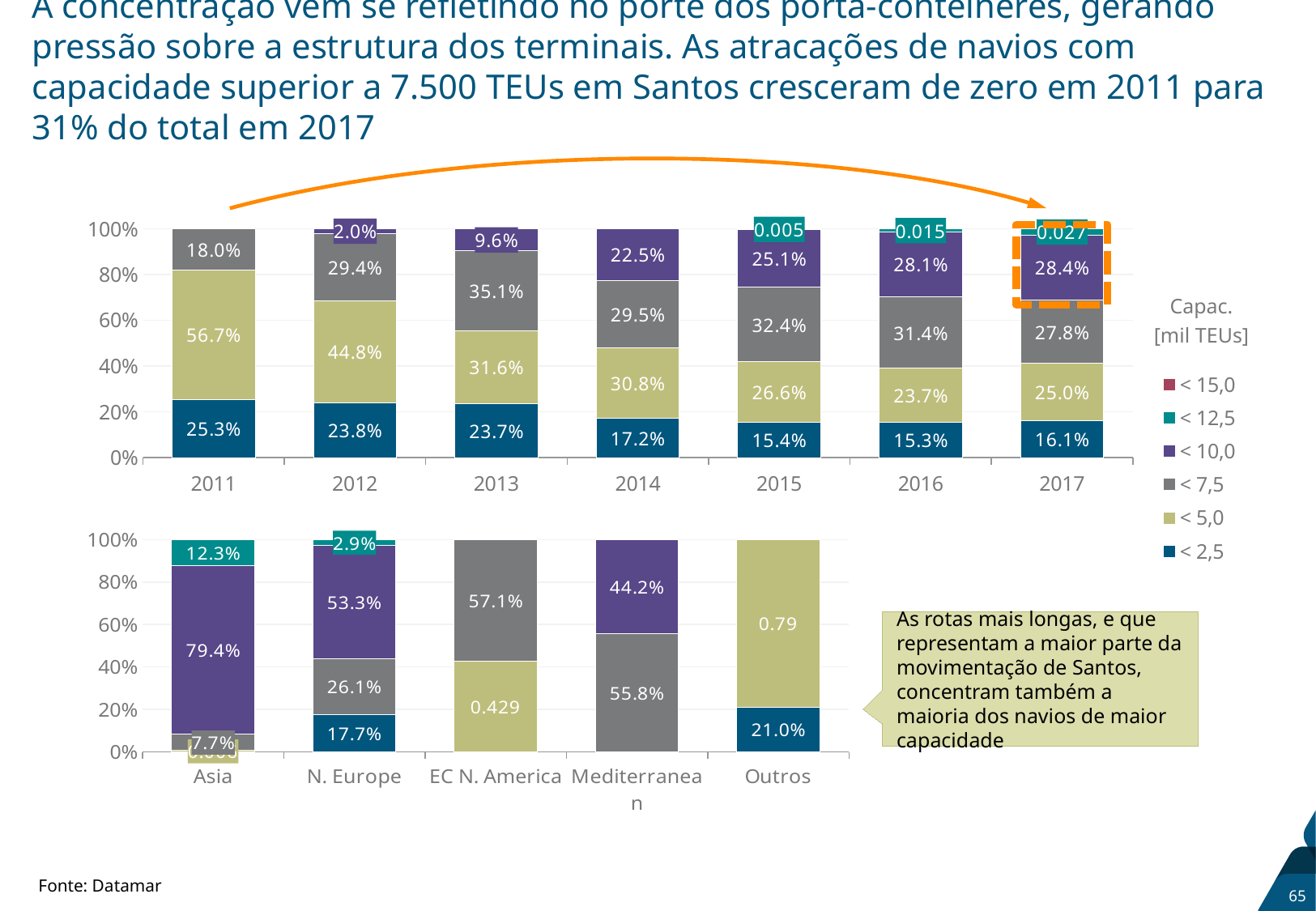
In the top chart, which year has the highest value for the '< 2,5' series? 2011 What kind of chart is the top chart? stacked bar chart In the bottom chart, for Mediterranean, which is larger: the '< 7,5' series or the '< 10,0' series? < 7,5 How many years are shown on the x axis of the top chart? 7 In the bottom chart, what is the value of the '< 10,0' series for Asia? 79.4% In the top chart, what is the value of the '< 10,0' series for 2017? 28.4% How many series does the legend list? 6 In the bottom chart, what is the value of the '< 2,5' series for N. Europe? 17.7% In the top chart, what is the difference between the '< 7,5' and '< 5,0' values for 2013? 3.5 percentage points In the top chart, does the '< 10,0' series rise or fall from 2012 to 2017? rise In the top chart, which year has the lowest value for the '< 2,5' series? 2016 In the top chart, what share of the 2011 bar is the '< 5,0' series? 56.7%